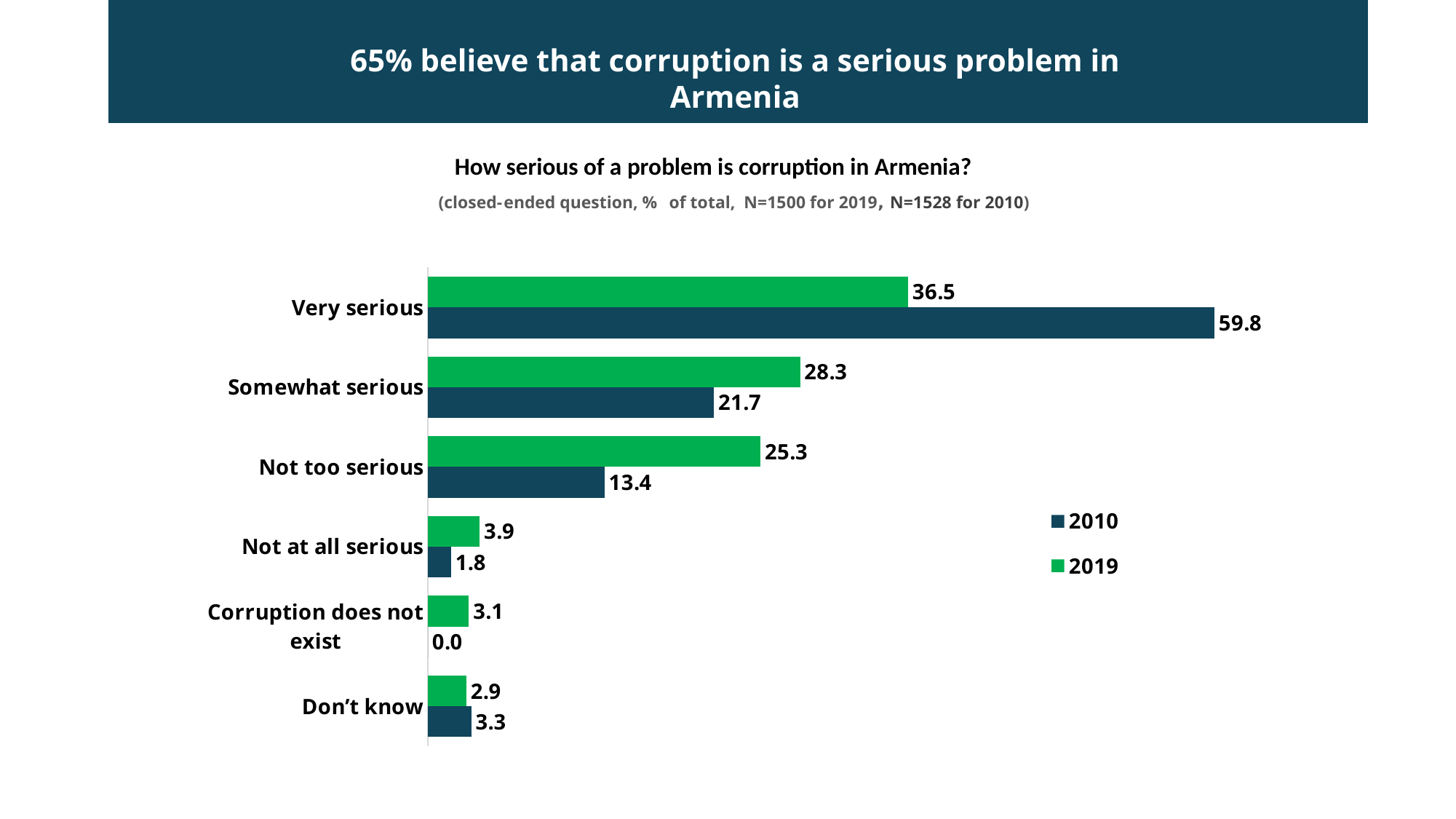
What is the 2019 value for "Very serious"? 36.5 Which category has the highest 2010 value? Very serious What is the difference between the 2019 and 2010 values for "Not too serious"? 11.9 What is the 2010 value for "Not too serious"? 13.4 Which is larger for "Somewhat serious": the 2010 value or the 2019 value? 2019 Which category has the lowest 2019 value? Don't know Which colour represents the 2019 series? Green What type of chart is shown on the slide? Bar chart How many response categories are shown on the chart? 6 What is the difference between the 2010 and 2019 values for "Very serious"? 23.3 How many series does the legend list? 2 What is the 2010 value for "Corruption does not exist"? 0.0